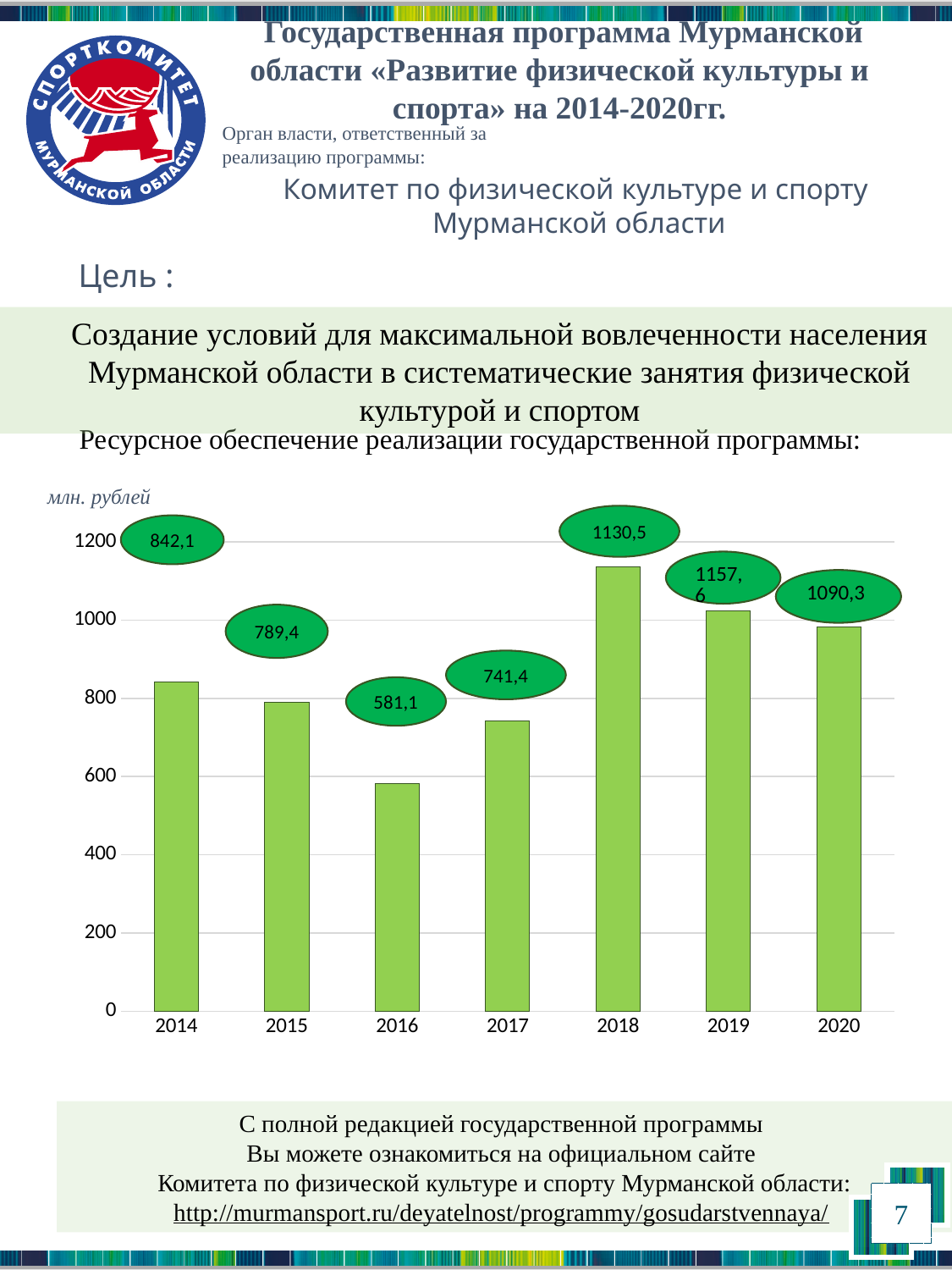
Is the value for 2017 greater or less than 800? less Which is larger, the value for 2014 or the value for 2015? 2014 What is the value for 2020? 1090,3 What is the difference between the values for 2017 and 2016? 160,3 What kind of chart is shown on the slide? bar chart What unit is indicated above the chart's vertical axis? млн. рублей What is the difference between the values for 2014 and 2015? 52,7 What is the value for 2018? 1130,5 How many years are shown on the x axis? 7 What is the value for 2016? 581,1 Which year has the lowest value? 2016 What is the value for 2014? 842,1